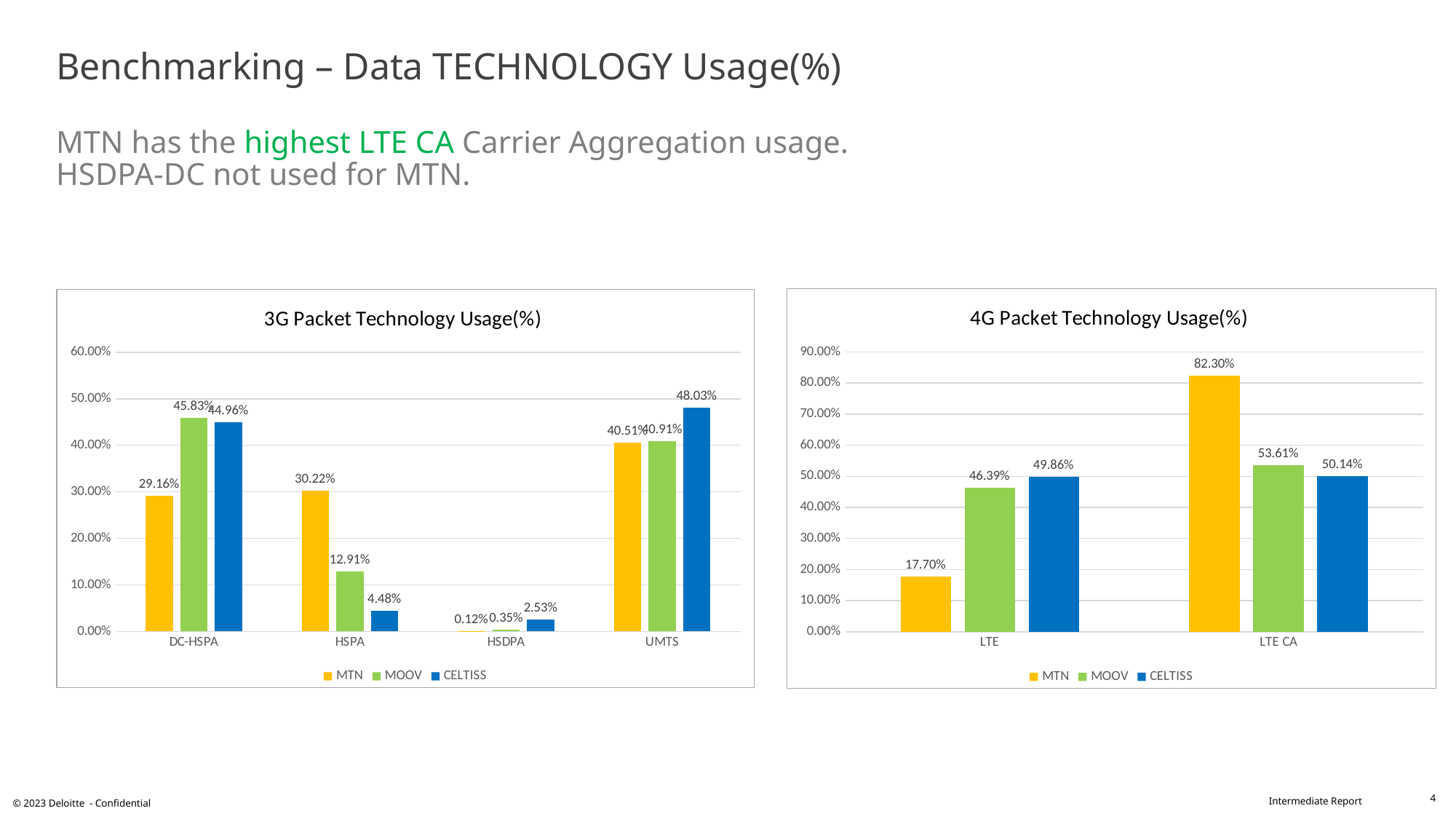
In the 3G Packet Technology Usage(%) chart, what is the value for CELTISS at UMTS? 48.03% In the 3G Packet Technology Usage(%) chart, which is larger at DC-HSPA: MOOV or CELTISS? MOOV In the 3G Packet Technology Usage(%) chart, which operator has the lowest value for HSPA? CELTISS In the 4G Packet Technology Usage(%) chart, which operator has the highest value for LTE? CELTISS What kind of chart is the 3G Packet Technology Usage(%) chart? Bar chart In the 3G Packet Technology Usage(%) chart, what is the value for MTN at HSPA? 30.22% How many technology categories are shown on the x axis of the 3G Packet Technology Usage(%) chart? 4 In the 4G Packet Technology Usage(%) chart, is the value for MTN at LTE greater or less than 20.00%? less In the 4G Packet Technology Usage(%) chart, what is the value for MTN at LTE CA? 82.30% In the 4G Packet Technology Usage(%) chart, what is the value for MOOV at LTE? 46.39% How many series does the legend of the 4G Packet Technology Usage(%) chart list? 3 In the 4G Packet Technology Usage(%) chart, what is the difference between the MTN and MOOV values at LTE CA? 28.69%